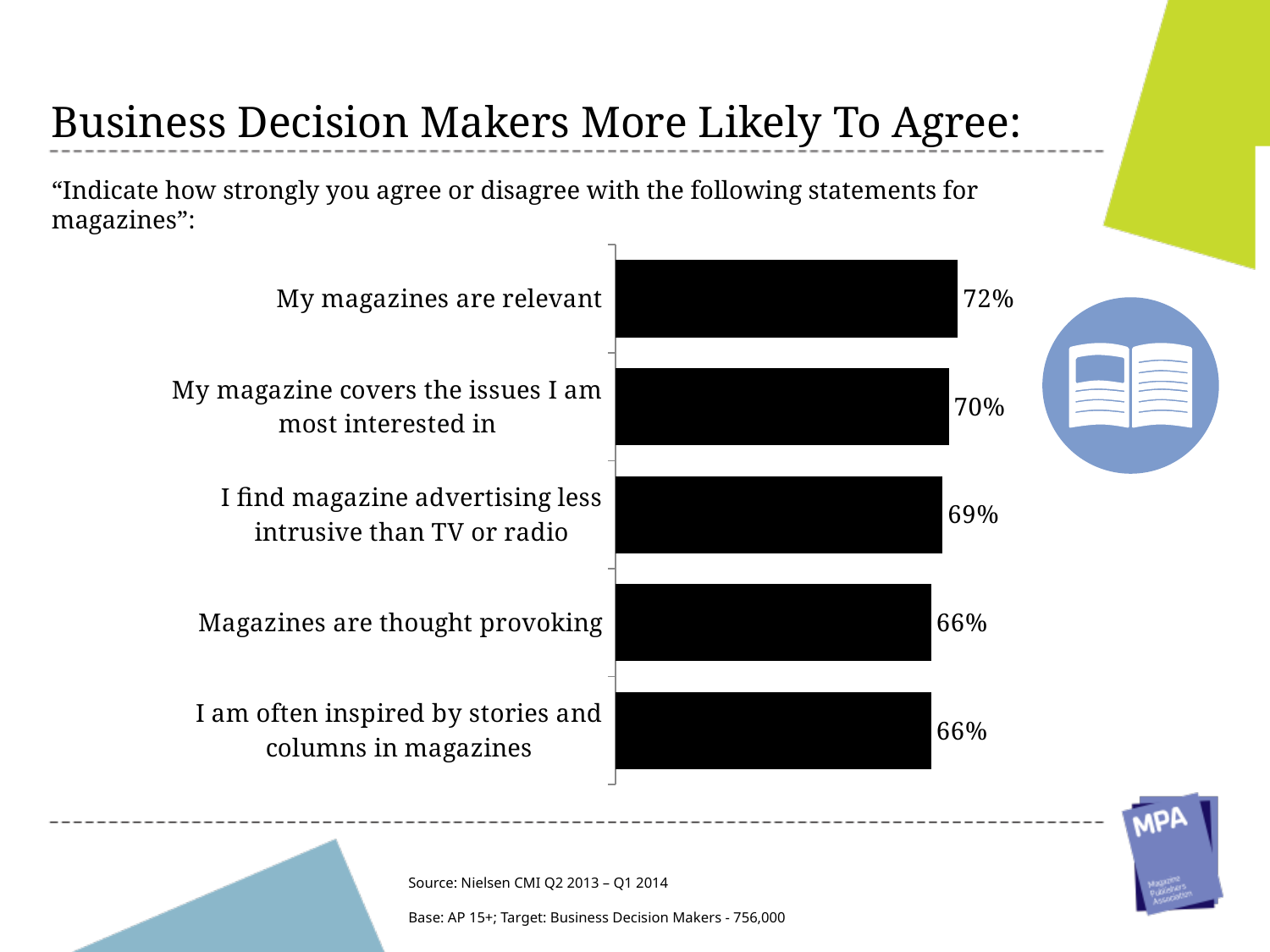
What is the value for "I find magazine advertising less intrusive than TV or radio"? 69% What is the value for "Magazines are thought provoking"? 66% What colour are the bars in the chart? Black Which is larger: the value for "My magazines are relevant" or the value for "I am often inspired by stories and columns in magazines"? My magazines are relevant What is the difference between the values for "My magazine covers the issues I am most interested in" and "I find magazine advertising less intrusive than TV or radio"? 1% How many statements are shown in the chart? 5 Do the values increase or decrease going from the top bar to the bottom bar? Decrease What percentage of business decision makers agree that "My magazines are relevant"? 72% What is the difference between the values for "My magazines are relevant" and "Magazines are thought provoking"? 6% What is the value for "My magazine covers the issues I am most interested in"? 70% What kind of chart is shown on the slide? Bar chart Which statement has the highest level of agreement? My magazines are relevant